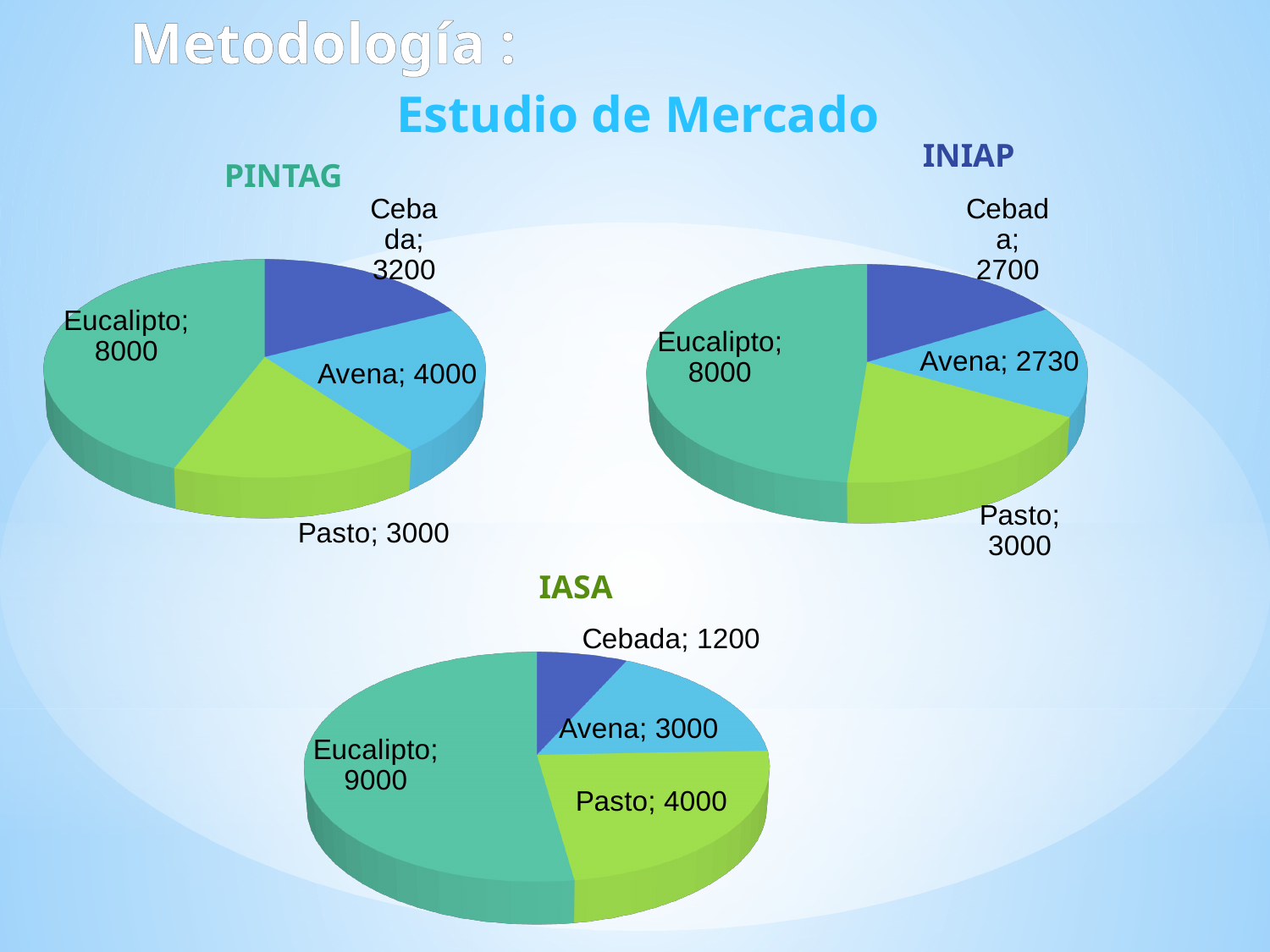
How many categories does the INIAP chart show? 4 In the PINTAG chart, what is the difference between Eucalipto and Avena? 4000 In the IASA chart, what is the value for Pasto? 4000 In the IASA chart, which is larger, Avena or Pasto? Pasto In the INIAP chart, what is the value for Cebada? 2700 How many pie charts are shown on the slide? 3 In the PINTAG chart, what is the value for Avena? 4000 In the IASA chart, which category has the largest value? Eucalipto What kind of chart is the IASA chart? Pie chart In the INIAP chart, what is the difference between Pasto and Cebada? 300 In the IASA chart, which category has the smallest value? Cebada In the PINTAG chart, which category has the smallest value? Pasto